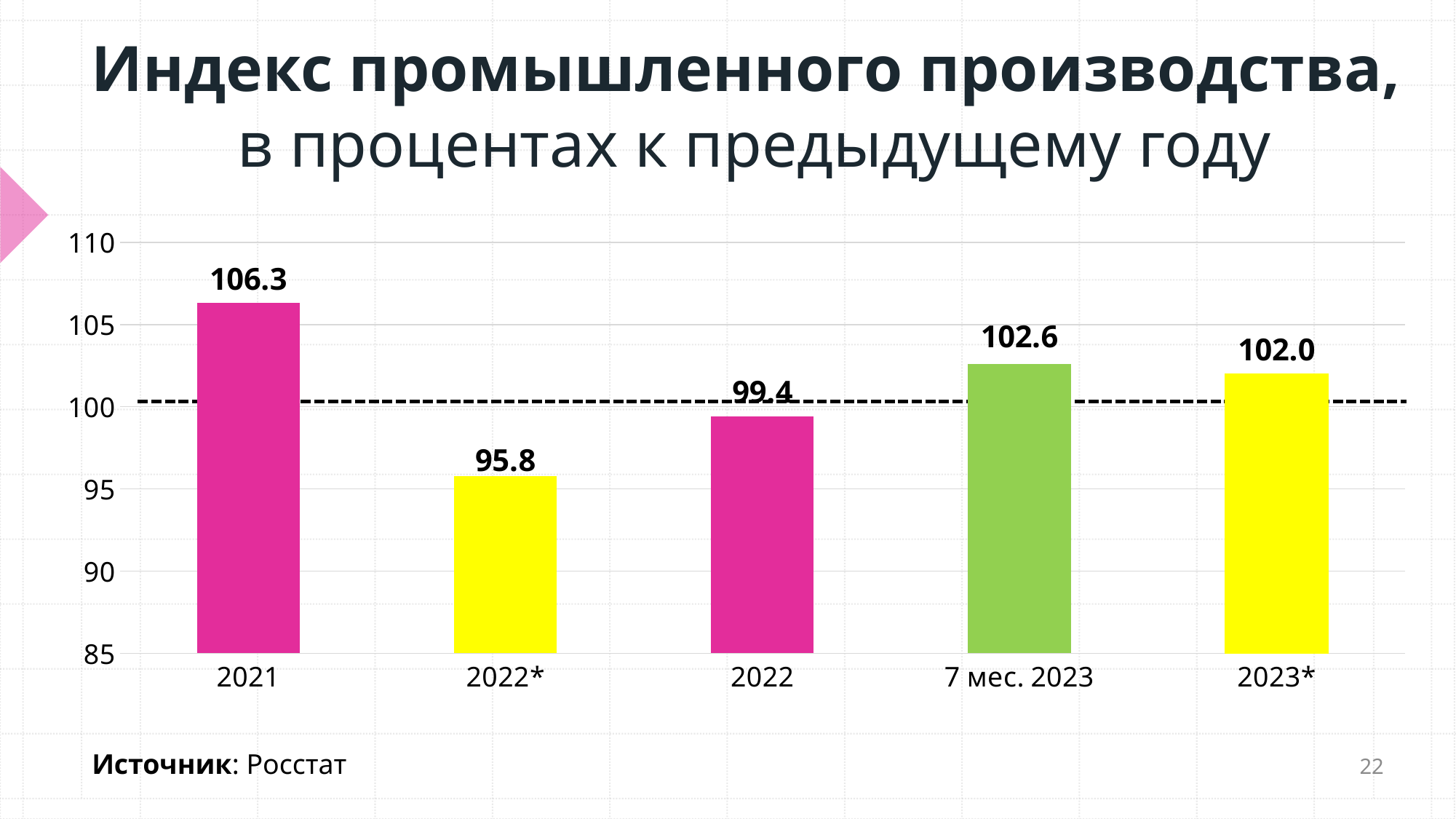
What is the difference between the values for 2021 and 2022? 6.9 What kind of chart is shown on the slide? bar chart Which category has the lowest value? 2022* What is the value for 2021? 106.3 What is the value for 2022*? 95.8 Is the value for 2022 greater or less than 100? less What is the source cited at the bottom of the slide? Росстат Which is larger, the value for 7 мес. 2023 or the value for 2023*? 7 мес. 2023 What is the value for 2023*? 102.0 What is the value for 7 мес. 2023? 102.6 How many bars are shown in the chart? 5 Which category has the highest value? 2021